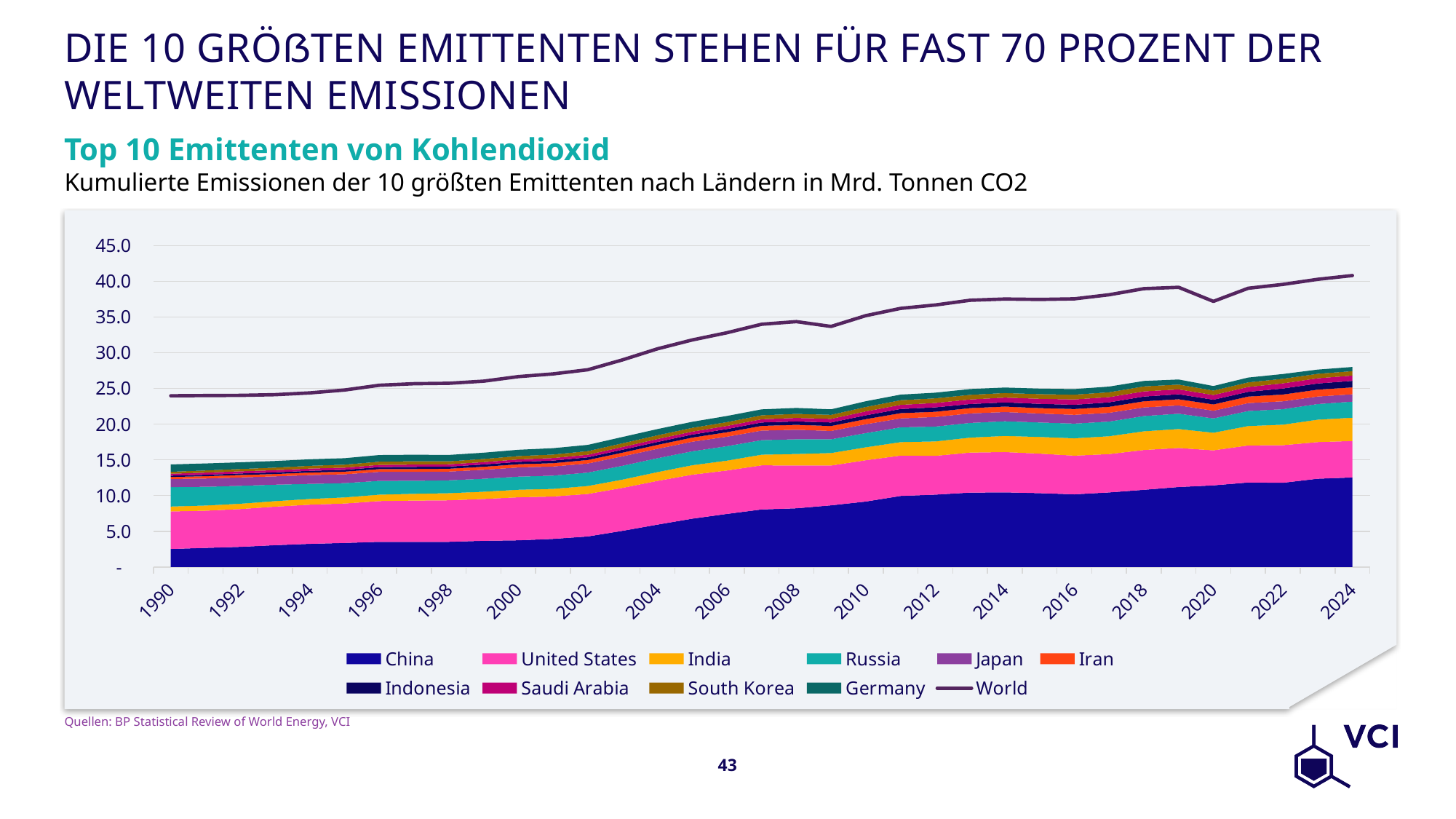
Is the value of the World line in 1990 greater or less than 30? less Does the World line generally rise or fall from 1990 to 2024? rise Is the China area in 2024 greater or less than 10? greater What kind of chart is shown on the slide? stacked area chart with a line Is the value of the World line in 2024 greater or less than 35? greater What is the title of the chart? Top 10 Emittenten von Kohlendioxid In 2024, which is larger: the China area or the United States area? China Which series is shown as a line rather than a filled area? World How many series does the legend list? 11 Is the World value in 2020 higher or lower than in 2019? lower